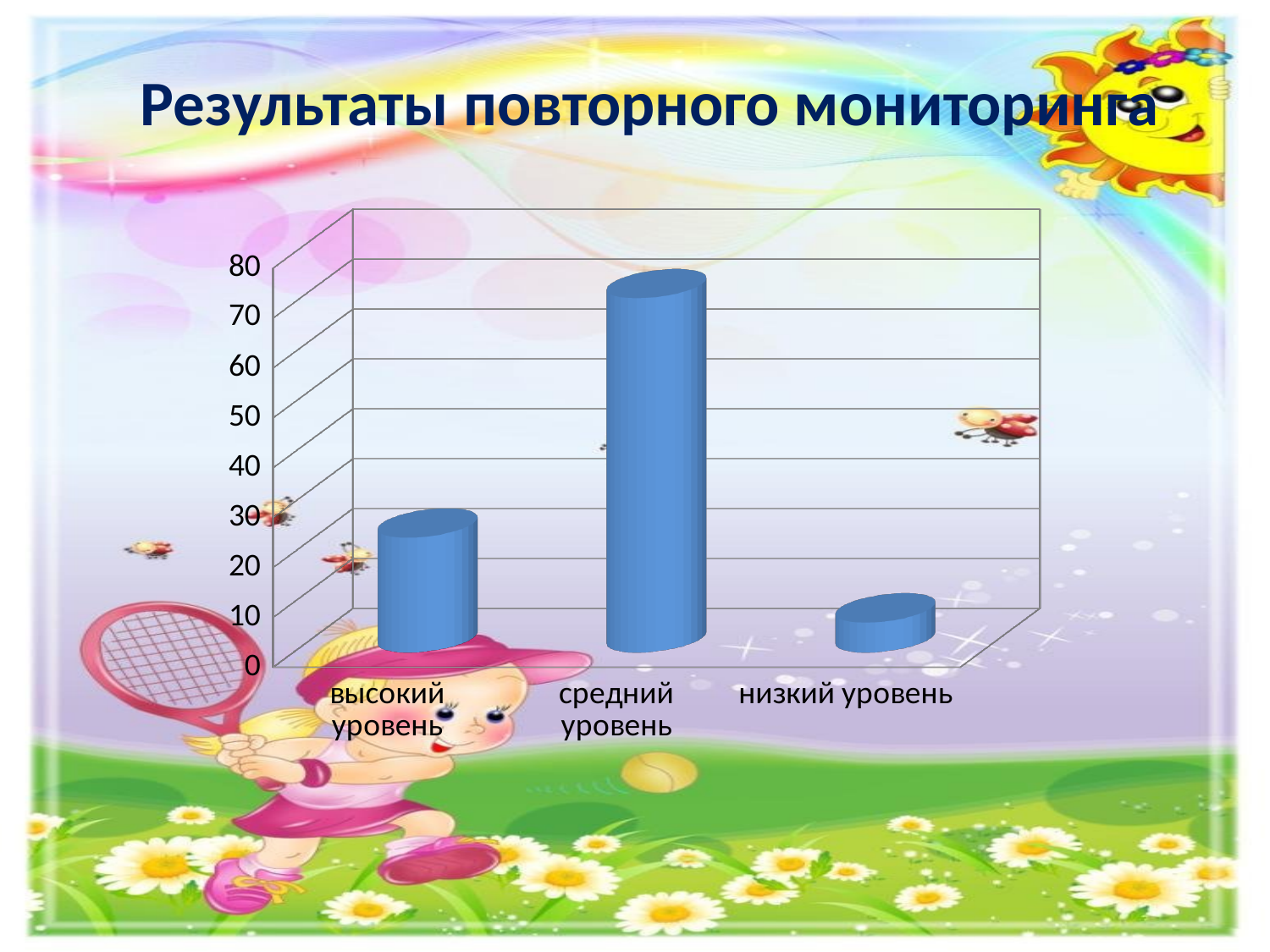
Is the value for высокий уровень greater or less than 40? less What is the highest value shown on the vertical axis of the chart? 80 What is the title of the slide containing the chart? Результаты повторного мониторинга Which is larger, the value for высокий уровень or the value for низкий уровень? высокий уровень What kind of chart is shown on the slide? bar chart Is the value for средний уровень greater or less than 60? greater Which category has the highest bar? средний уровень Which category has the lowest bar? низкий уровень How many categories are shown on the x axis of the chart? 3 Is the value for высокий уровень greater or less than 10? greater Which is larger, the value for средний уровень or the value for высокий уровень? средний уровень